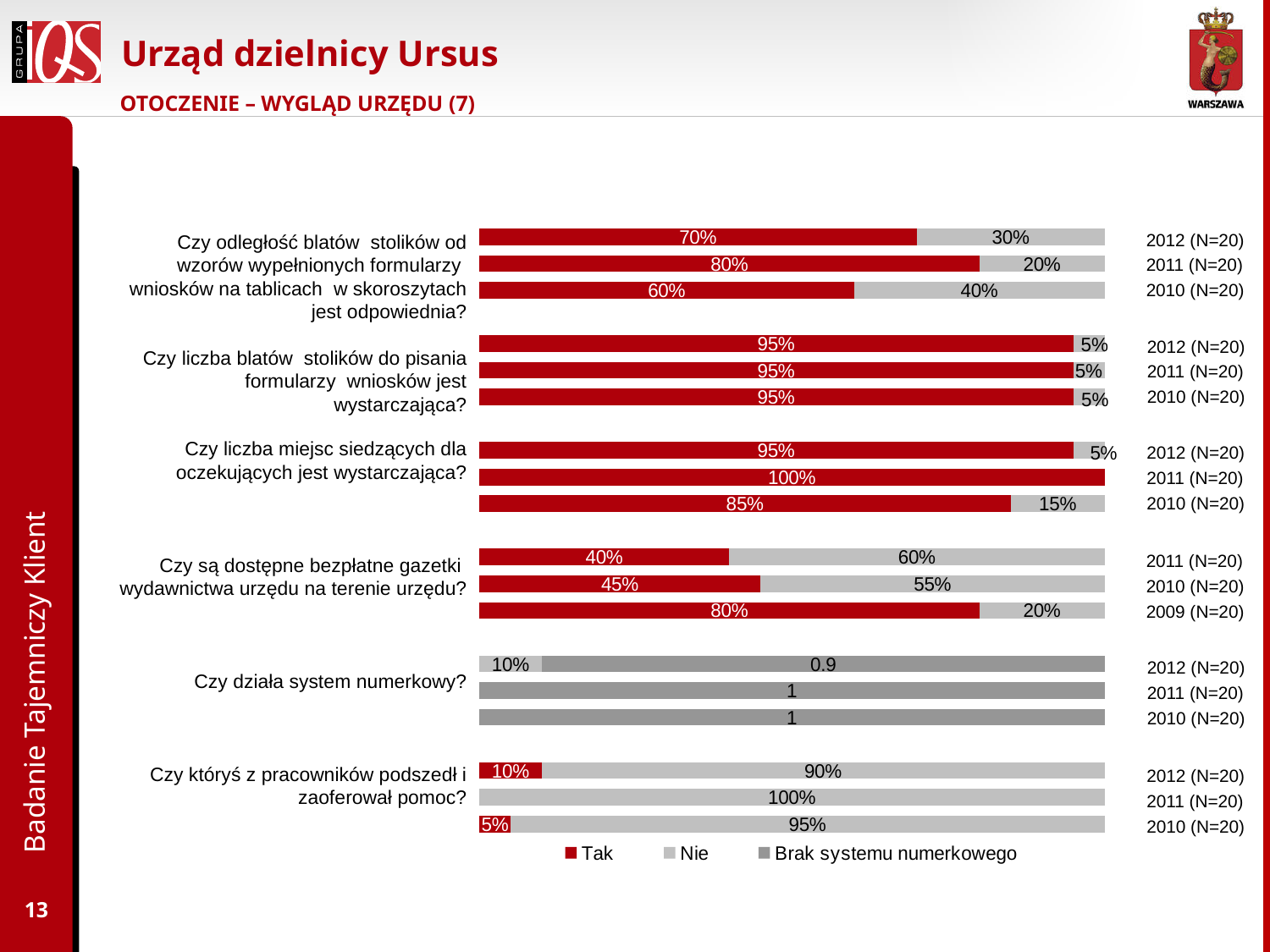
What is the "Tak" value for 2012 (N=20) in the row "Czy któryś z pracowników podszedł i zaoferował pomoc?"? 10% What are the three legend entries of the chart? Tak, Nie, Brak systemu numerkowego What is the "Tak" value for 2011 (N=20) in the row "Czy liczba miejsc siedzących dla oczekujących jest wystarczająca?"? 100% What is the "Nie" value for 2011 (N=20) in the row "Czy są dostępne bezpłatne gazetki wydawnictwa urzędu na terenie urzędu?"? 60% In the row "Czy odległość blatów stolików od wzorów wypełnionych formularzy wniosków na tablicach w skoroszytach jest odpowiednia?", what is the difference between the "Tak" values for 2011 (N=20) and 2010 (N=20)? 20 percentage points What kind of chart is shown on the slide? Stacked bar chart What is the "Nie" value for 2010 (N=20) in the row "Czy odległość blatów stolików od wzorów wypełnionych formularzy wniosków na tablicach w skoroszytach jest odpowiednia?"? 40% What is the "Tak" value for 2012 (N=20) in the row "Czy odległość blatów stolików od wzorów wypełnionych formularzy wniosków na tablicach w skoroszytach jest odpowiednia?"? 70% In the row "Czy są dostępne bezpłatne gazetki wydawnictwa urzędu na terenie urzędu?", which year has the highest "Tak" value? 2009 (N=20) What label is printed on the dark grey segment for 2012 (N=20) in the row "Czy działa system numerkowy?"? 0.9 How many series does the legend list? 3 In the row "Czy są dostępne bezpłatne gazetki wydawnictwa urzędu na terenie urzędu?", does the "Tak" value rise or fall from 2009 to 2011? Fall